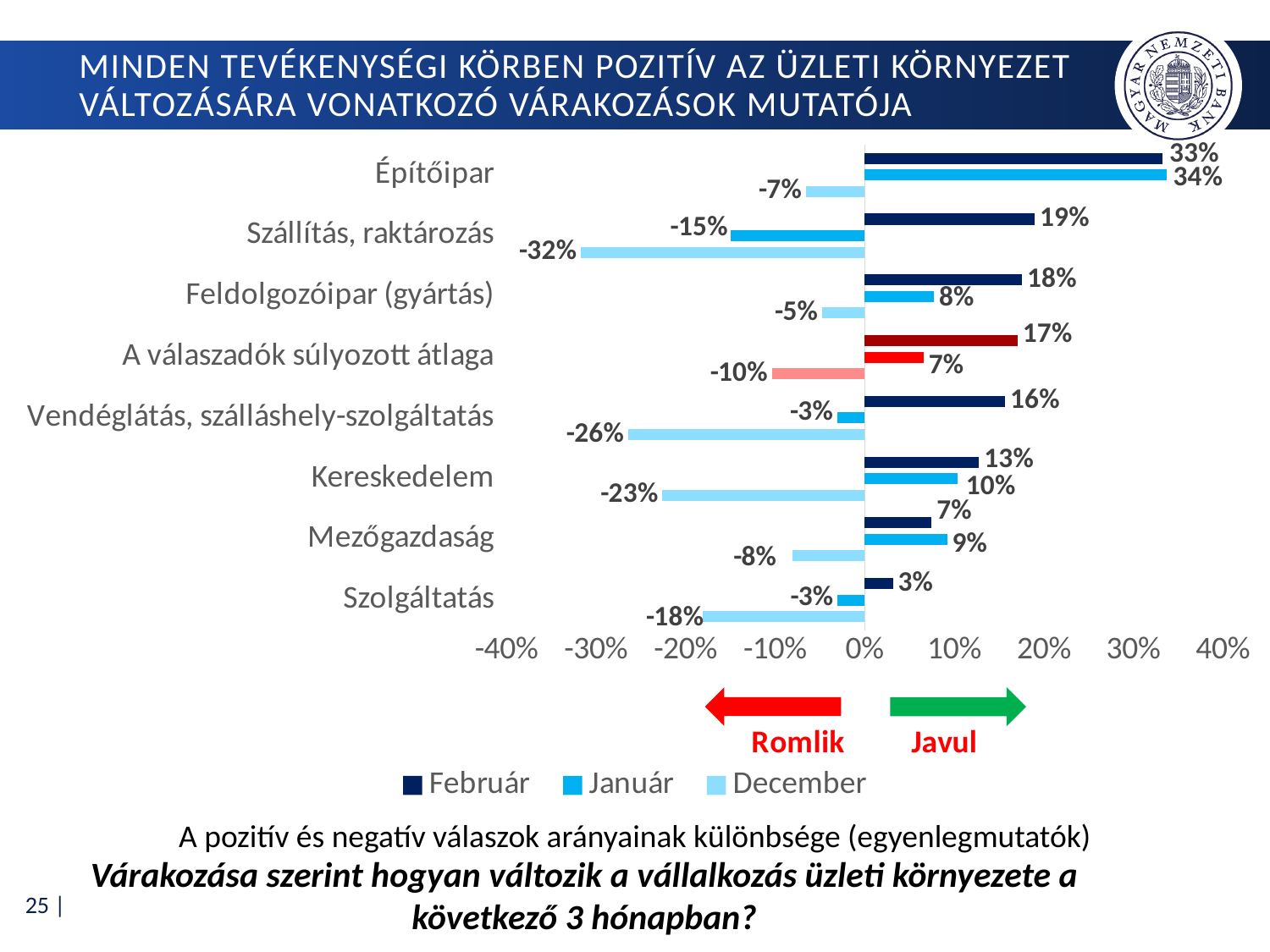
What is the Február value for A válaszadók súlyozott átlaga? 17% What is the Január value for Kereskedelem? 10% What is the difference between the Február and Január values for Feldolgozóipar (gyártás)? 10 percentage points Which category has the lowest December value? Szállítás, raktározás How many categories are shown on the chart? 8 For Mezőgazdaság, which is larger: the Február value or the Január value? Január What is the Február value for Építőipar? 33% Which series is shown in the lightest blue colour in the legend? December What kind of chart is shown on the slide? Bar chart How many series does the legend list? 3 What is the December value for Szállítás, raktározás? -32% Which category has the highest Február value? Építőipar